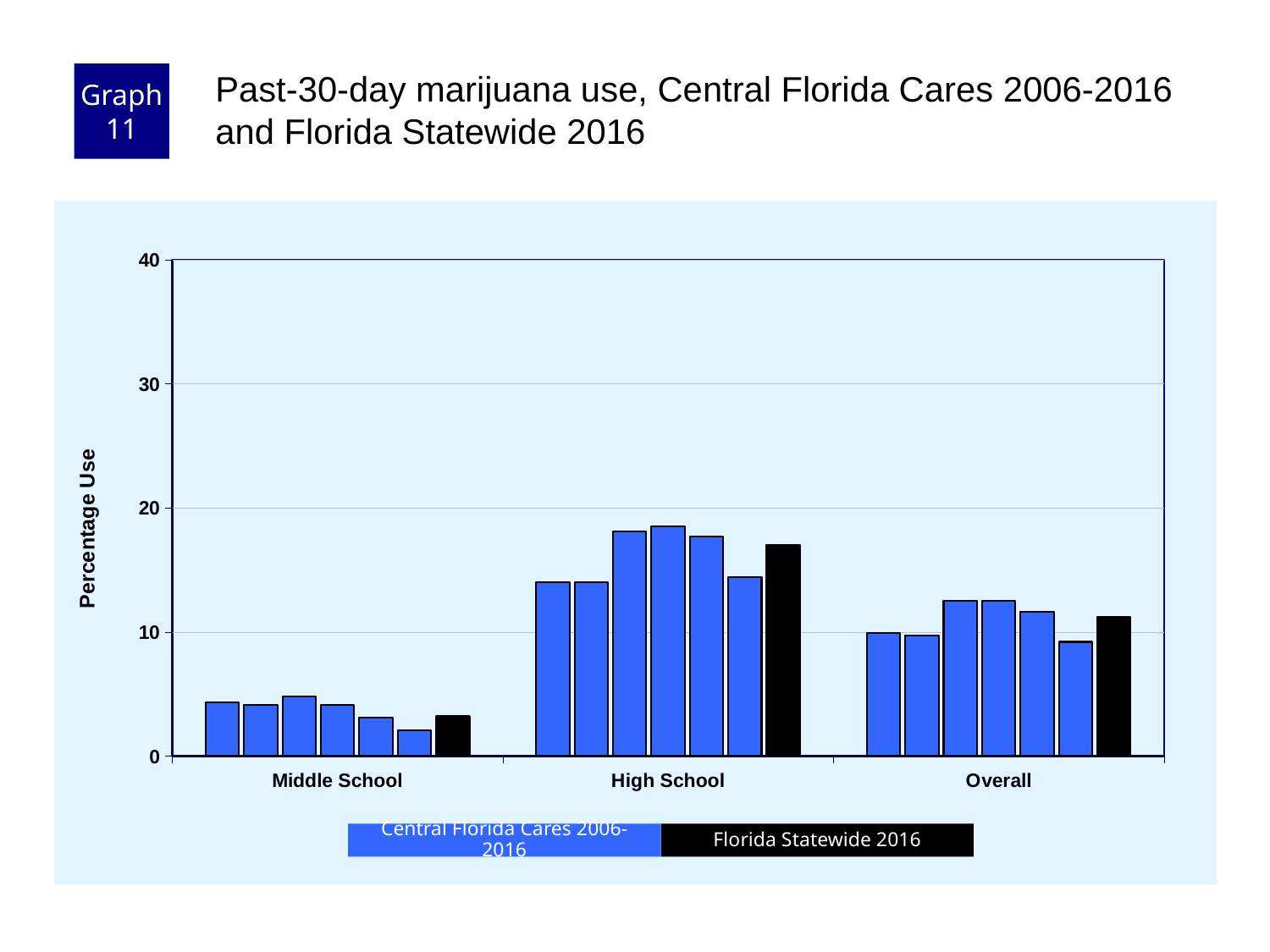
What kind of chart is shown on the slide? bar chart Which is larger, the Florida Statewide 2016 value for Overall or for Middle School? Overall Is the Florida Statewide 2016 value for High School greater or less than 20? less How many categories are shown on the x axis? 3 Which category has the lowest values? Middle School Is the Florida Statewide 2016 value for Middle School greater or less than 10? less Which is larger, the Florida Statewide 2016 value for High School or for Middle School? High School Which category has the highest values? High School Is the Florida Statewide 2016 value for High School greater or less than 10? greater What is the label on the y axis? Percentage Use How many series does the legend list? 2